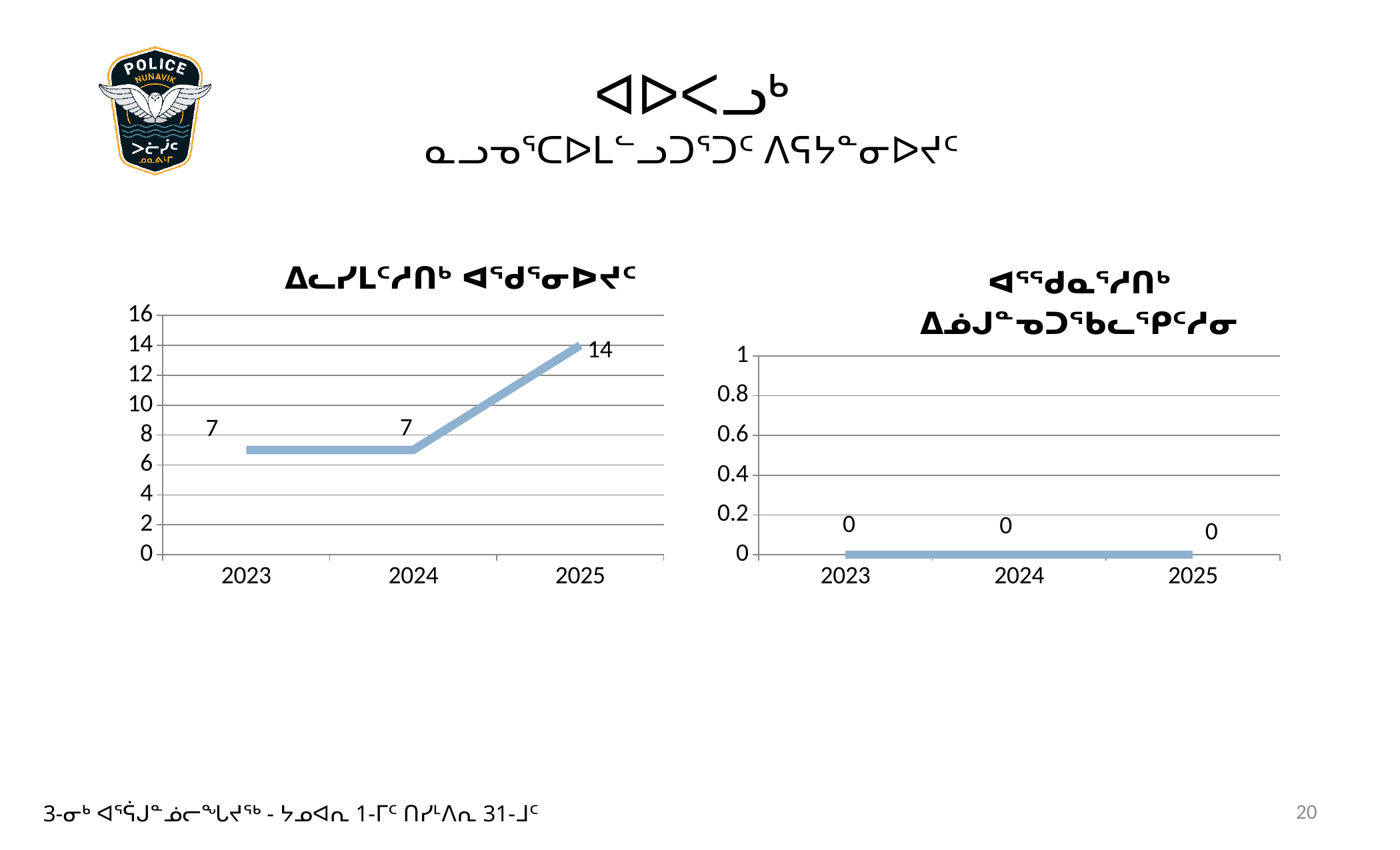
What is the highest value shown on the y axis of the right chart? 1 On the right chart, what is the value for 2024? 0 On the left chart, is the value for 2025 larger than the value for 2023? Yes On the left chart, do the values rise or fall from 2024 to 2025? Rise On the left chart, which year has the highest value? 2025 What kind of chart is the left chart? Line chart On the left chart, is the value for 2024 greater or less than 10? less On the right chart, what is the total of the values for 2023, 2024 and 2025? 0 How many years are plotted on the left chart? 3 On the left chart, what is the value for 2023? 7 On the left chart, what is the value for 2025? 14 On the left chart, what is the difference between the values for 2025 and 2024? 7